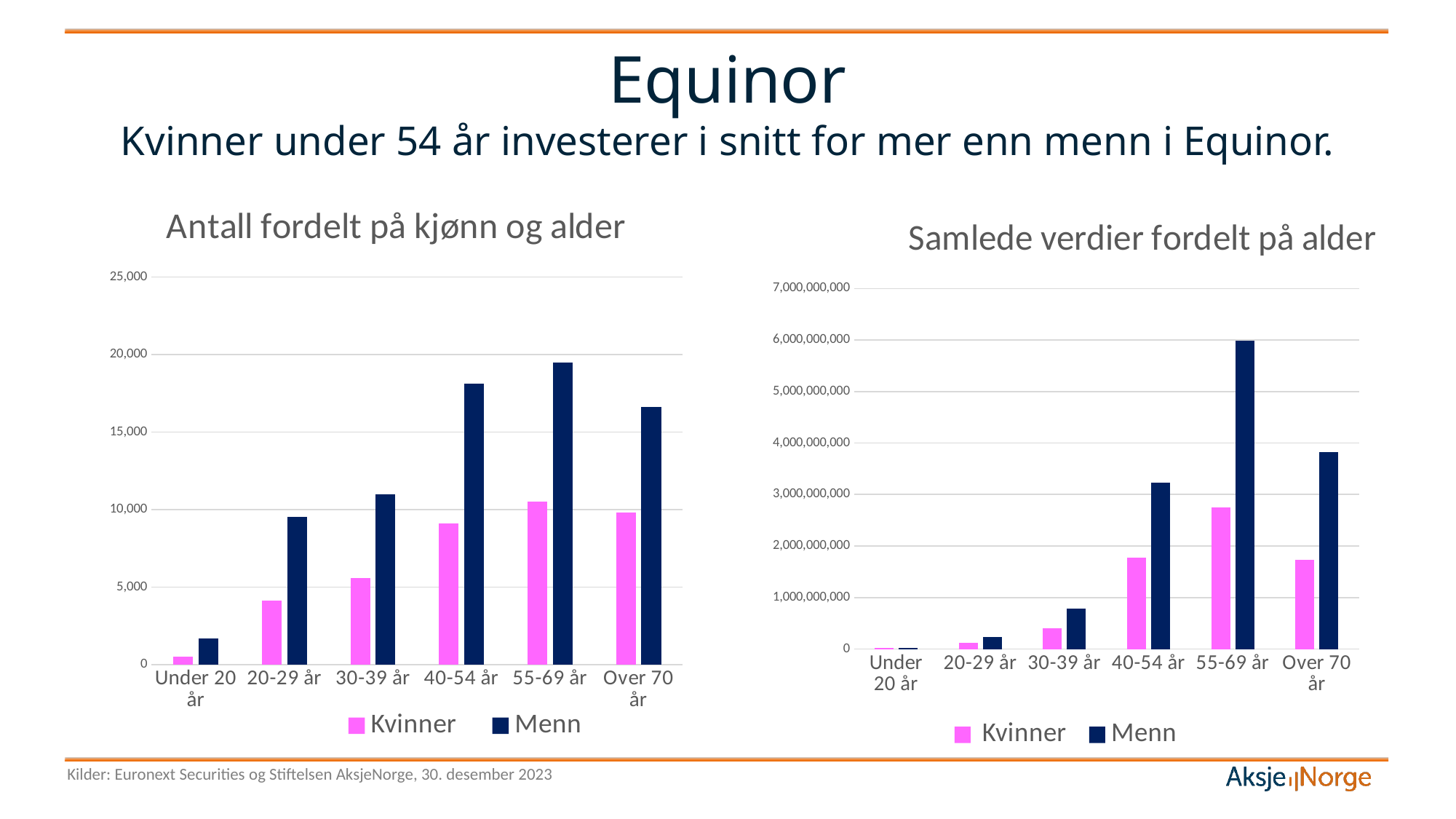
In the chart titled "Antall fordelt på kjønn og alder", which age group has the highest value for Menn? 55-69 år In the chart titled "Antall fordelt på kjønn og alder", is the value for Menn in the 40-54 år group greater or less than 15,000? greater In the chart titled "Antall fordelt på kjønn og alder", which age group has the lowest value for Kvinner? Under 20 år How many series does the legend list in the chart titled "Samlede verdier fordelt på alder"? 2 In the chart titled "Samlede verdier fordelt på alder", is the value for Kvinner in the 40-54 år group greater or less than 2,000,000,000? less What kind of chart is the chart titled "Samlede verdier fordelt på alder"? Bar chart In the chart titled "Samlede verdier fordelt på alder", is the value for Menn in the 55-69 år group greater or less than 5,000,000,000? greater In the chart titled "Antall fordelt på kjønn og alder", which is larger for the 30-39 år group, Kvinner or Menn? Menn How many age groups are shown on the x axis of the chart titled "Antall fordelt på kjønn og alder"? 6 In the chart titled "Samlede verdier fordelt på alder", which age group has the highest value for Menn? 55-69 år In the chart titled "Samlede verdier fordelt på alder", which age group has the highest value for Kvinner? 55-69 år